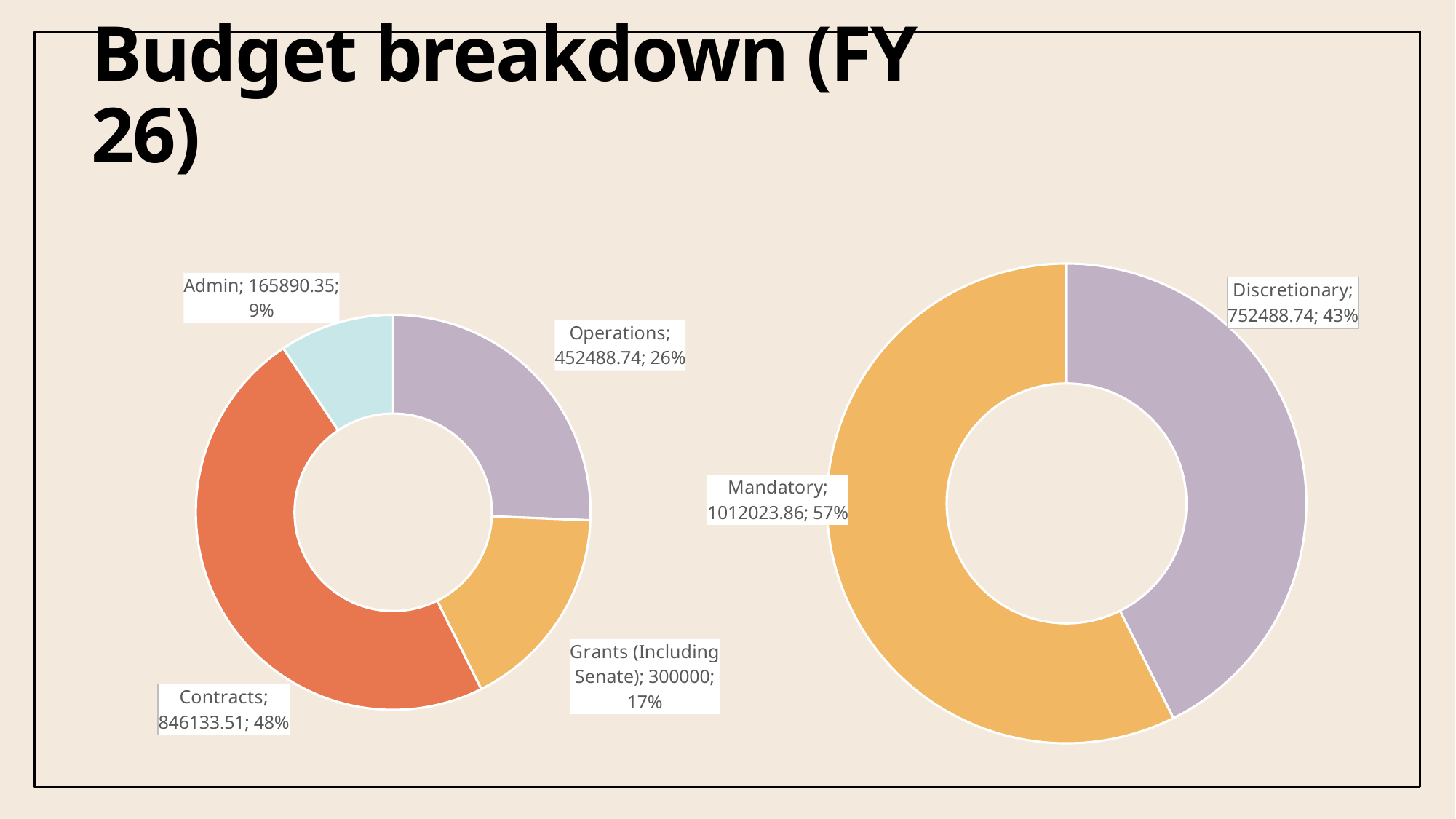
In the left chart, what is the value for Grants (Including Senate)? 300000 In the left chart, which category has the smallest value? Admin In the right chart, what is the value for Mandatory? 1012023.86 In the right chart, what share of the total does Discretionary represent? 43% In the right chart, which is larger, Mandatory or Discretionary? Mandatory In the left chart, what is the difference between the values for Operations and Admin? 286598.39 In the left chart, which category has the largest value? Contracts In the right chart, what is the difference between the values for Mandatory and Discretionary? 259535.12 In the left chart, what share of the total does Operations represent? 26% In the left chart, how many categories are shown? 4 In the left chart, what is the value for Contracts? 846133.51 What type of chart is the right chart? Doughnut chart